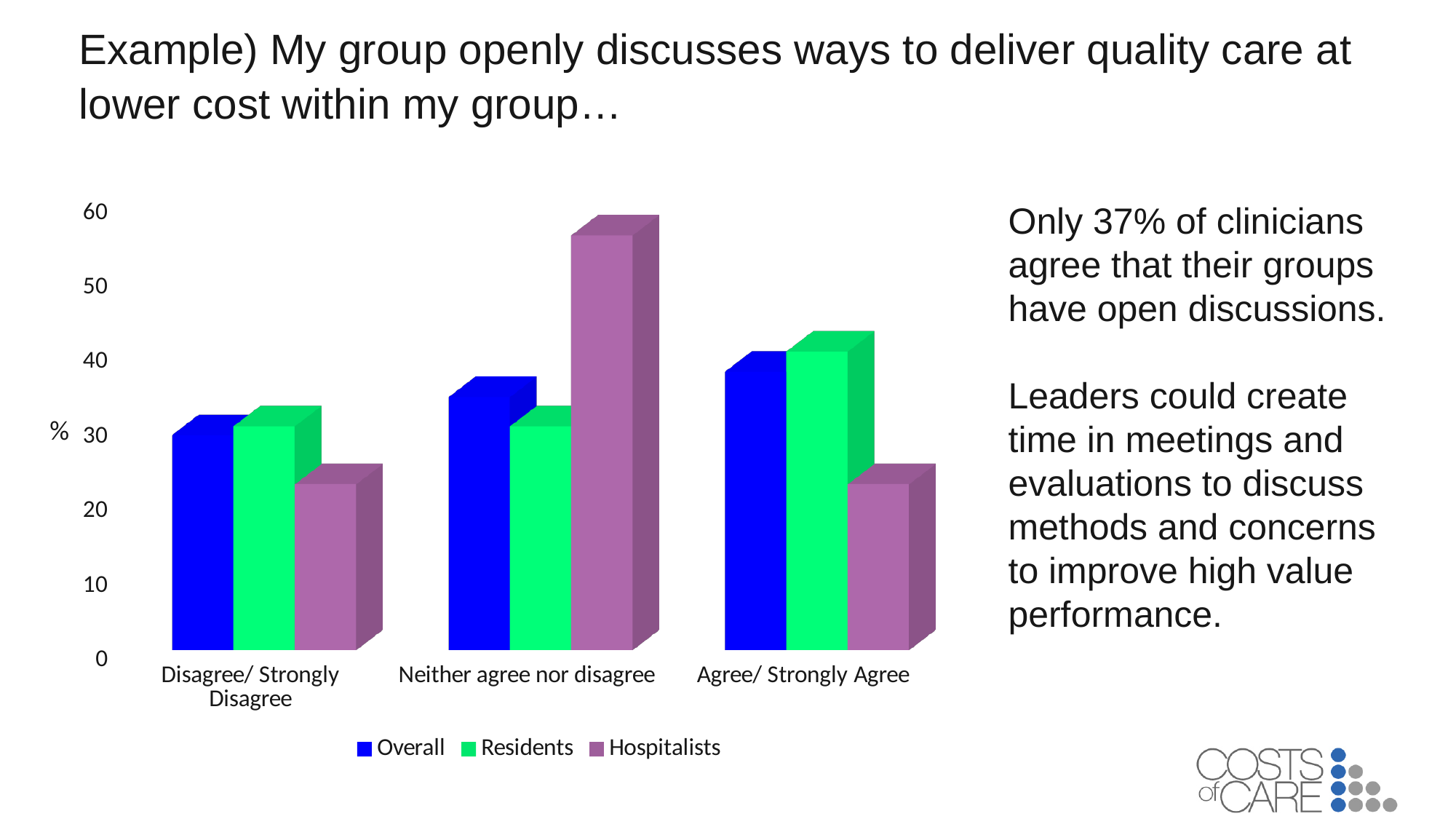
Which is larger for Hospitalists: the value for 'Neither agree nor disagree' or the value for 'Agree/ Strongly Agree'? Neither agree nor disagree What colour represents the Hospitalists series in the chart? purple What is the label on the chart's vertical axis? % How many categories are shown on the x axis of the chart? 3 Which is larger for Residents: the value for 'Agree/ Strongly Agree' or the value for 'Disagree/ Strongly Disagree'? Agree/ Strongly Agree Is the Hospitalists value for 'Disagree/ Strongly Disagree' greater or less than 30? less How many series does the chart's legend list? 3 What kind of chart is shown on the slide? bar chart Which series has the highest value in the 'Neither agree nor disagree' category? Hospitalists Which series has the lowest value in the 'Agree/ Strongly Agree' category? Hospitalists Is the Residents value for 'Agree/ Strongly Agree' greater or less than 30? greater Is the Hospitalists value for 'Neither agree nor disagree' greater or less than 50? greater